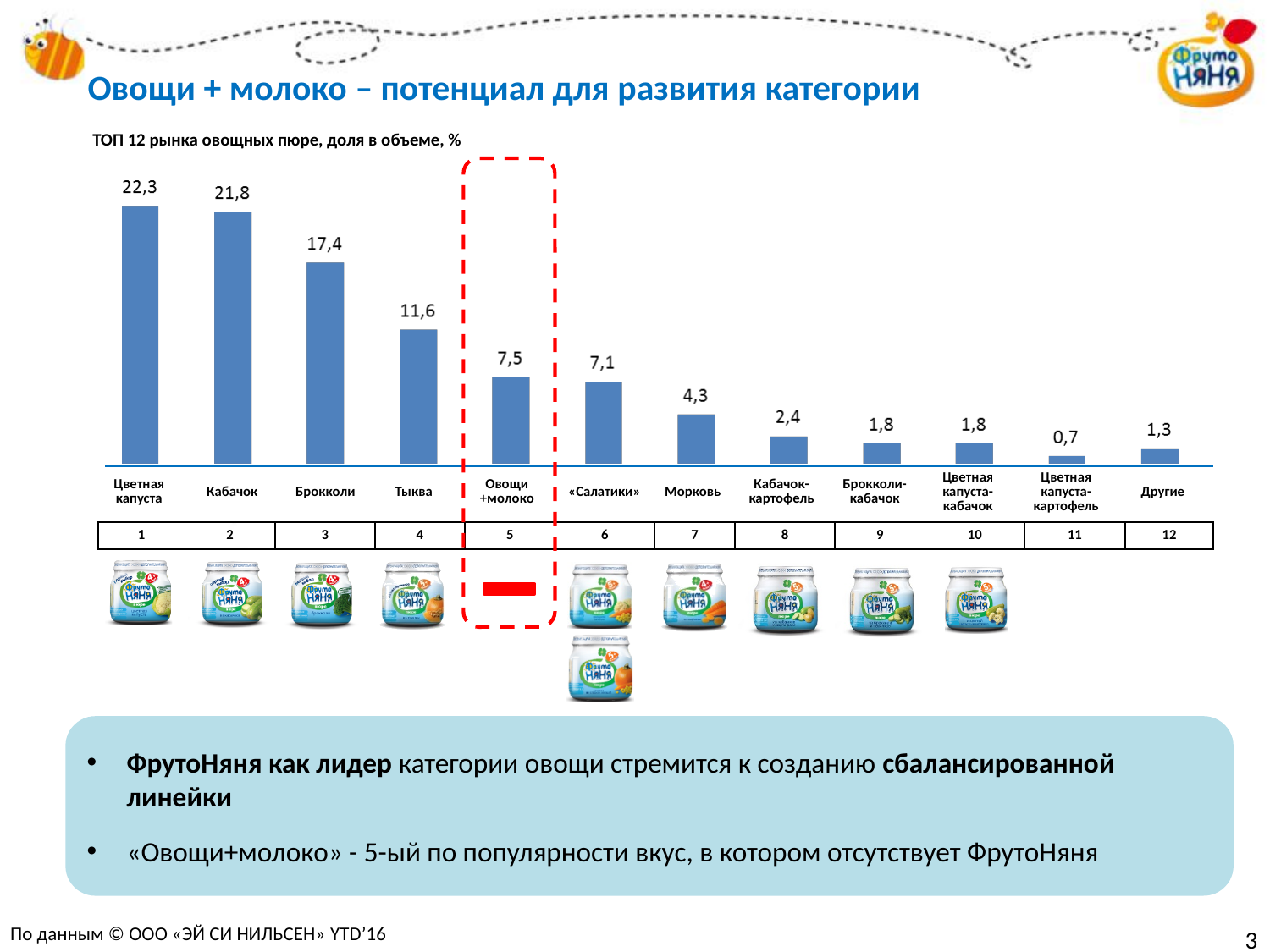
What is the value for Овощи+молоко? 7,5 Do the values generally rise or fall from left to right across the first 11 categories? Fall What kind of chart is shown on the slide? Bar chart What is the difference between the values for Кабачок and Брокколи? 4,4 How many categories are shown in the chart? 12 Which category has the highest value? Цветная капуста What is the value for Морковь? 4,3 What is the value for Цветная капуста-картофель? 0,7 What is the title of the chart? ТОП 12 рынка овощных пюре, доля в объеме, % Which is larger, the value for Тыква or the value for «Салатики»? Тыква Which category has the lowest value? Цветная капуста-картофель What is the value for Цветная капуста? 22,3